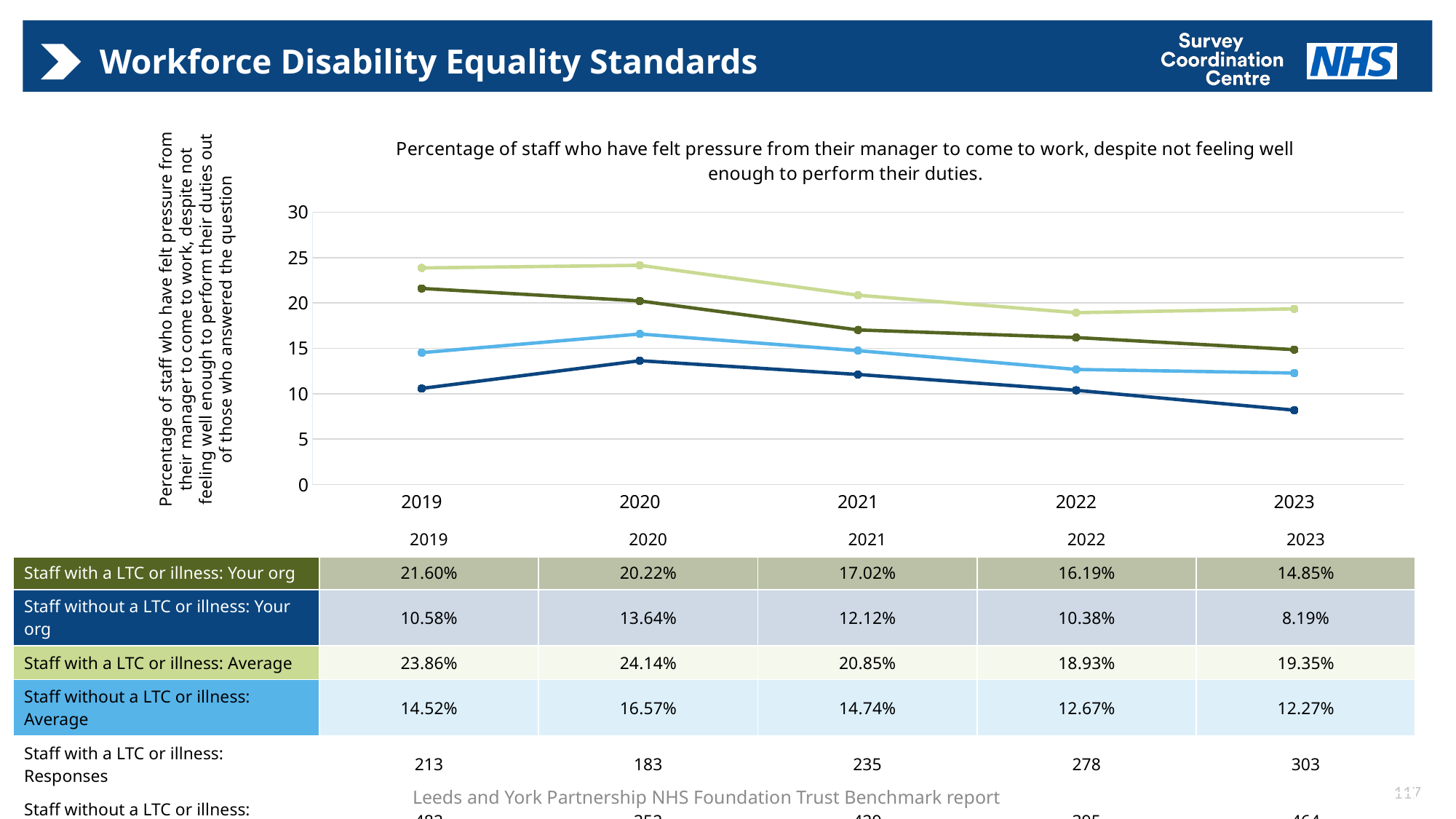
What is the value for 'Staff without a LTC or illness: Average' in 2022? 12.67% What is the value for 'Staff with a LTC or illness: Your org' in 2019? 21.60% How many data series are plotted in the chart? 4 In which year is the value for 'Staff with a LTC or illness: Average' highest? 2020 What is the value for 'Staff with a LTC or illness: Average' in 2020? 24.14% How many years are plotted along the x axis of the chart? 5 What is the difference between 'Staff with a LTC or illness: Your org' and 'Staff without a LTC or illness: Your org' in 2023? 6.66% Does the value for 'Staff with a LTC or illness: Your org' rise or fall from 2019 to 2023? fall What is the value for 'Staff without a LTC or illness: Your org' in 2023? 8.19% What type of chart is shown on the slide? line chart In which year is the value for 'Staff without a LTC or illness: Your org' lowest? 2023 Which is larger in 2021: 'Staff with a LTC or illness: Your org' or 'Staff without a LTC or illness: Average'? Staff with a LTC or illness: Your org